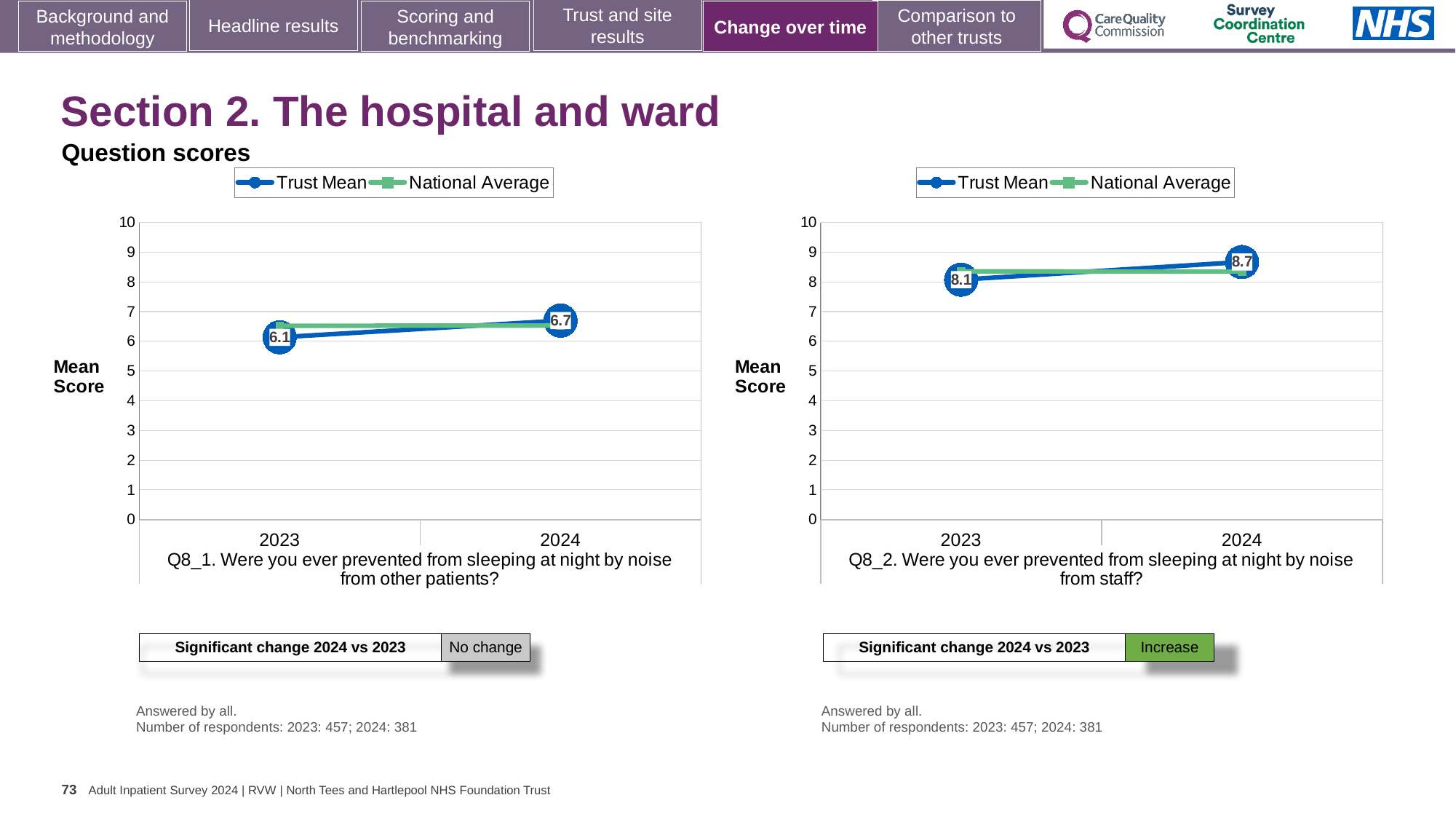
What kind of chart is the Q8_1 chart (left)? line chart In the Q8_2 chart (right), does the Trust Mean rise or fall from 2023 to 2024? rise How many series does the legend of the Q8_1 chart (left) list? 2 In the Q8_2 chart (right), what is the Trust Mean for 2024? 8.7 In the Q8_1 chart (left), by how much did the Trust Mean change from 2023 to 2024? 0.6 In the Q8_1 chart (left), what is the Trust Mean for 2024? 6.7 How many years are plotted on the x axis of the Q8_2 chart (right)? 2 In the Q8_2 chart (right), what is the difference between the Trust Mean in 2024 and in 2023? 0.6 In the Q8_2 chart (right), what is the Trust Mean for 2023? 8.1 In the Q8_1 chart (left), what is the Trust Mean for 2023? 6.1 In the Q8_1 chart (left), is the Trust Mean for 2024 greater or less than the Trust Mean for 2023? greater In the Q8_2 chart (right), is the National Average for 2023 greater or less than 7? greater